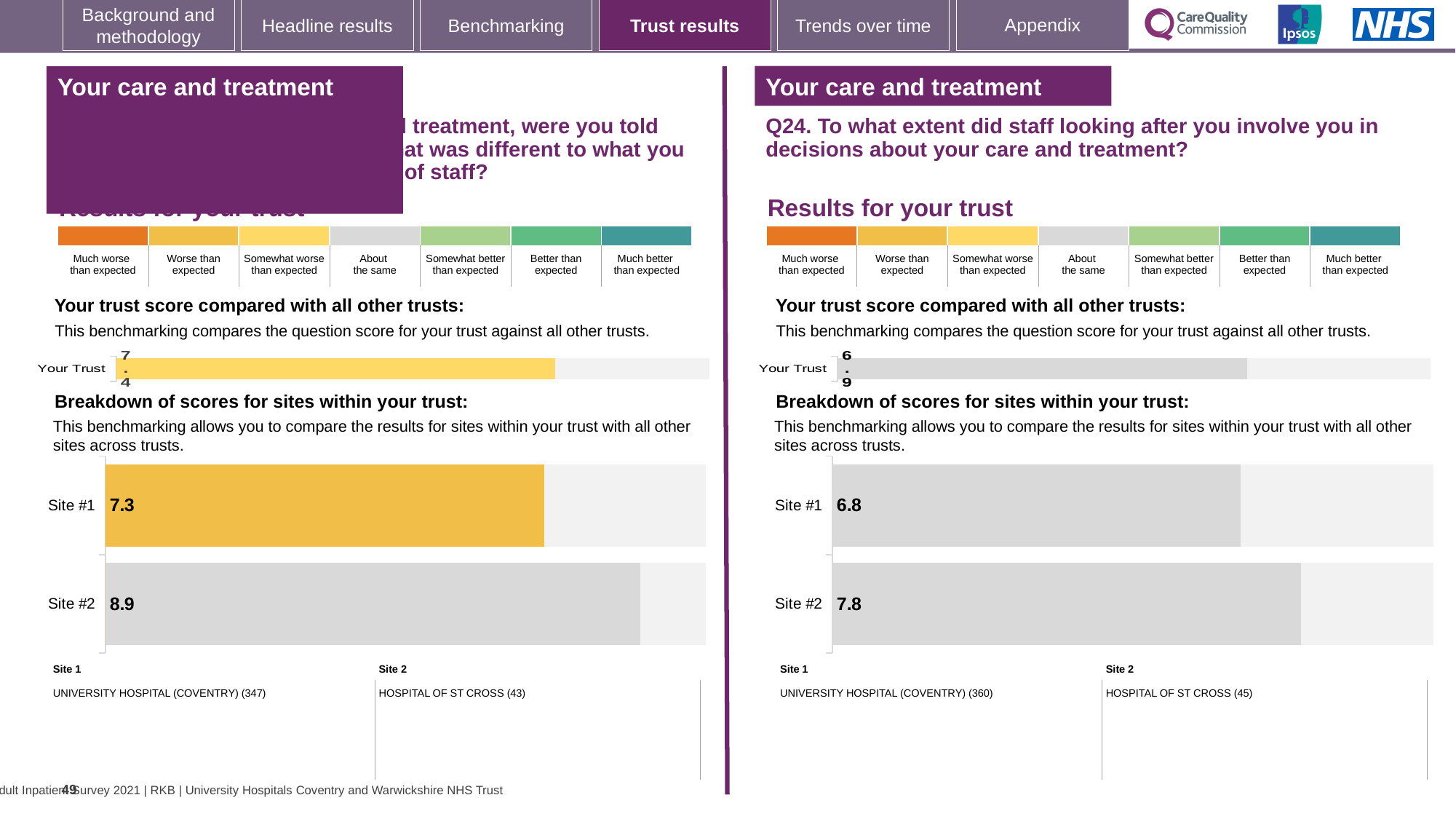
In the site breakdown chart on the left side of the slide, what is the score for Site #2? 8.9 In the Q24 site breakdown chart on the right side of the slide, which site has the lower score? Site #1 In the Q24 site breakdown chart on the right side of the slide, what is the score for Site #1? 6.8 How many sites are shown in the Q24 site breakdown chart on the right side of the slide? 2 In the site breakdown chart on the left side of the slide, what is the score for Site #1? 7.3 In the site breakdown chart on the left side of the slide, what is the difference between the Site #2 and Site #1 scores? 1.6 In the Q24 site breakdown chart on the right side of the slide, what is the difference between the Site #2 and Site #1 scores? 1.0 In the 'Your trust score compared with all other trusts' chart on the left side of the slide, what is the score for Your Trust? 7.4 In the site breakdown chart on the left side of the slide, which site has the higher score? Site #2 What type of chart is used for the site breakdown on the left side of the slide? Bar chart In the Q24 site breakdown chart on the right side of the slide, what is the score for Site #2? 7.8 In the 'Your trust score compared with all other trusts' chart on the right side of the slide (Q24), what is the score for Your Trust? 6.9